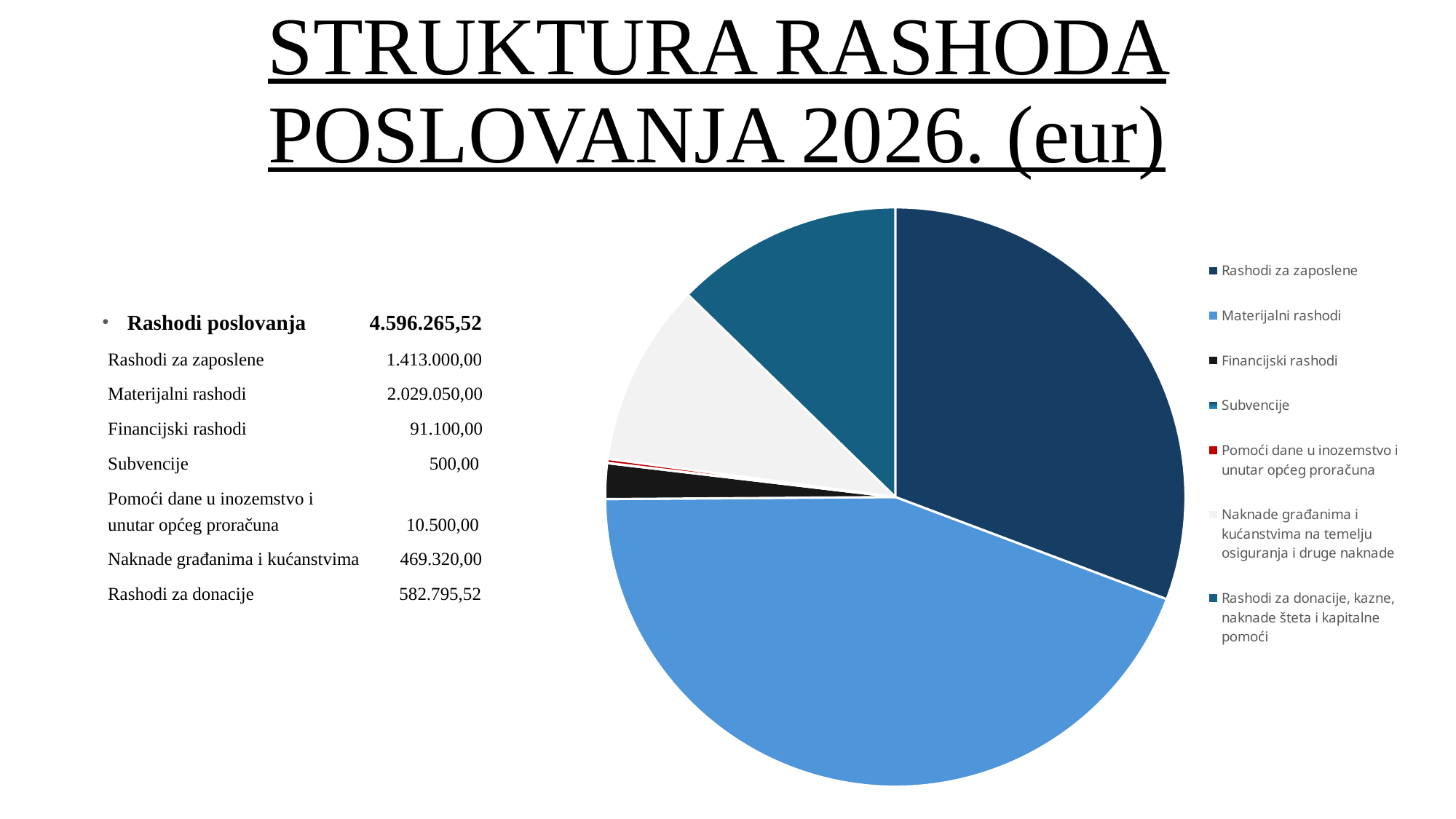
What is the value for Financijski rashodi? 91.100,00 What is the title of the slide containing the pie chart? STRUKTURA RASHODA POSLOVANJA 2026. (eur) What is the value for Pomoći dane u inozemstvo i unutar općeg proračuna? 10.500,00 What is the total of Rashodi poslovanja shown on the slide? 4.596.265,52 How many slices does the pie chart have? 7 What kind of chart is shown on the slide? pie chart How many entries does the legend of the pie chart list? 7 Which category has the smallest value according to the slide? Subvencije What is the difference between Materijalni rashodi and Rashodi za zaposlene? 616.050,00 Which category has the largest slice of the pie chart? Materijalni rashodi What is the value for Rashodi za zaposlene? 1.413.000,00 Which is larger, Rashodi za zaposlene or Materijalni rashodi? Materijalni rashodi